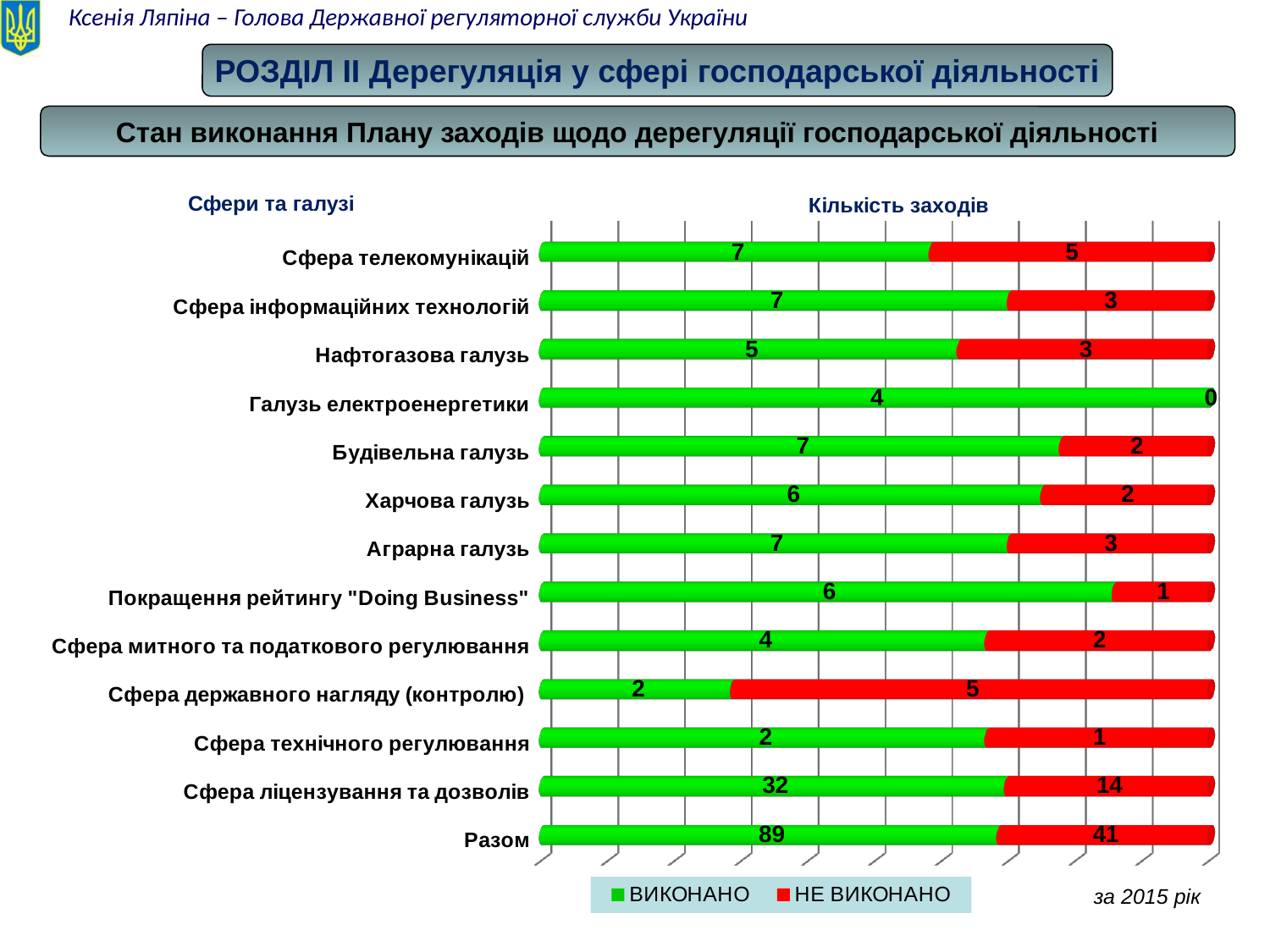
Excluding Разом, which category has the highest НЕ ВИКОНАНО value? Сфера ліцензування та дозволів Which category has the highest ВИКОНАНО value? Разом What is the total of the ВИКОНАНО and НЕ ВИКОНАНО values for Сфера телекомунікацій? 12 What is the НЕ ВИКОНАНО value for Галузь електроенергетики? 0 What is the ВИКОНАНО value for Сфера ліцензування та дозволів? 32 What is the НЕ ВИКОНАНО value for Сфера державного нагляду (контролю)? 5 What is the difference between the ВИКОНАНО and НЕ ВИКОНАНО values for Разом? 48 How many series does the legend list? 2 What is the ВИКОНАНО value for Сфера телекомунікацій? 7 Which is larger for Сфера державного нагляду (контролю): ВИКОНАНО or НЕ ВИКОНАНО? НЕ ВИКОНАНО What kind of chart is shown on the slide? Stacked bar chart How many categories are shown on the chart? 13